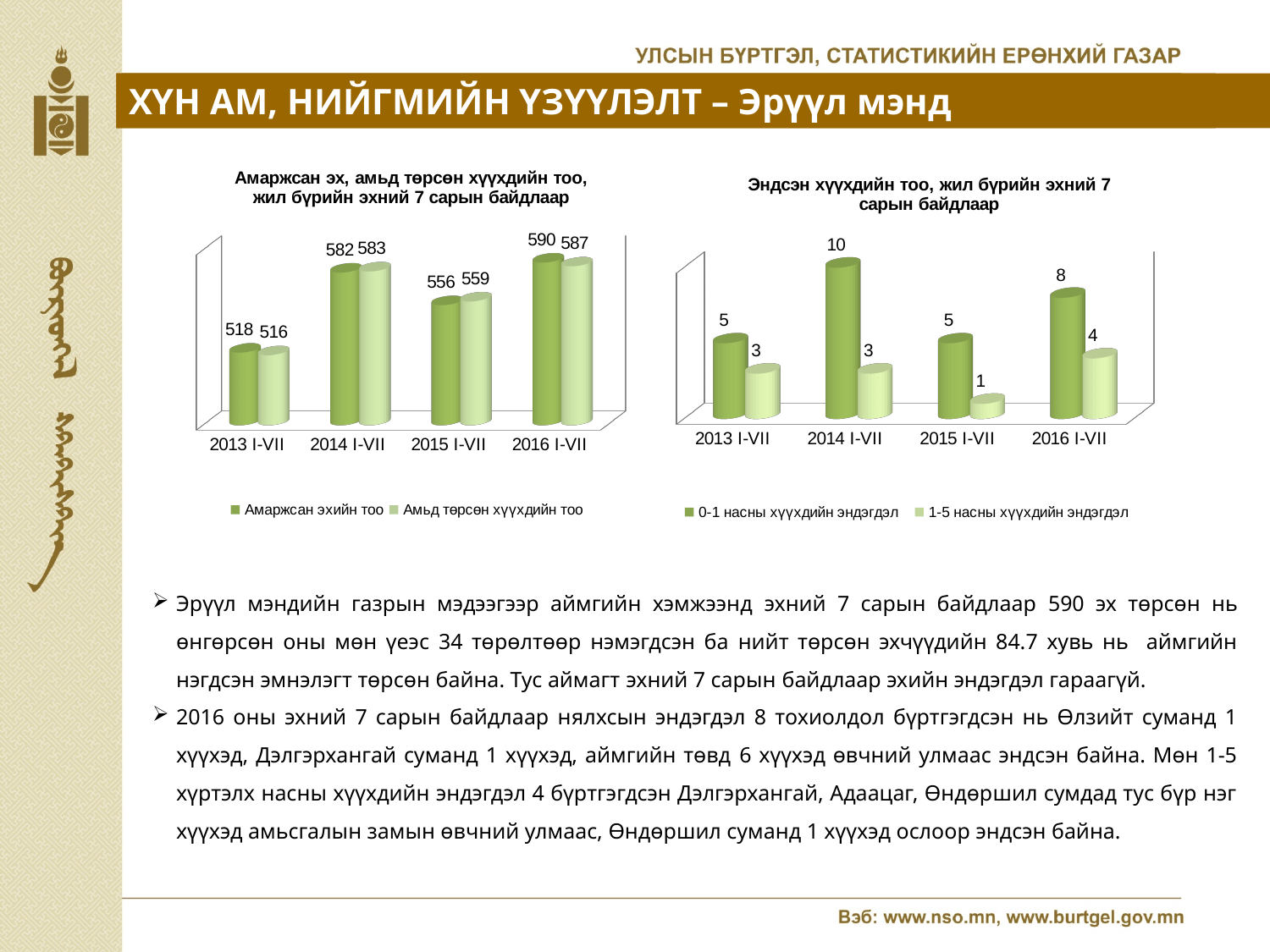
In the left chart (Амаржсан эх, амьд төрсөн хүүхдийн тоо), what is the value of Амьд төрсөн хүүхдийн тоо for 2013 I-VII? 516 In the left chart (Амаржсан эх, амьд төрсөн хүүхдийн тоо), what is the value of Амаржсан эхийн тоо for 2016 I-VII? 590 In the right chart (Эндсэн хүүхдийн тоо), what is the value of 1-5 насны хүүхдийн эндэгдэл for 2015 I-VII? 1 What kind of chart is the left chart (Амаржсан эх, амьд төрсөн хүүхдийн тоо)? Bar chart In the left chart (Амаржсан эх, амьд төрсөн хүүхдийн тоо), which year has the lowest value for Амаржсан эхийн тоо? 2013 I-VII In the right chart (Эндсэн хүүхдийн тоо), what is the value of 0-1 насны хүүхдийн эндэгдэл for 2014 I-VII? 10 In the left chart (Амаржсан эх, амьд төрсөн хүүхдийн тоо), how many series does the legend list? 2 In the right chart (Эндсэн хүүхдийн тоо), which year has the highest value for 0-1 насны хүүхдийн эндэгдэл? 2014 I-VII In the left chart (Амаржсан эх, амьд төрсөн хүүхдийн тоо), what is the difference between Амаржсан эхийн тоо in 2016 I-VII and 2015 I-VII? 34 How many year categories are shown on the x axis of the right chart (Эндсэн хүүхдийн тоо)? 4 In the right chart (Эндсэн хүүхдийн тоо), what is the difference between 0-1 насны and 1-5 насны хүүхдийн эндэгдэл in 2014 I-VII? 7 In the right chart (Эндсэн хүүхдийн тоо), which is larger in 2016 I-VII: 0-1 насны хүүхдийн эндэгдэл or 1-5 насны хүүхдийн эндэгдэл? 0-1 насны хүүхдийн эндэгдэл